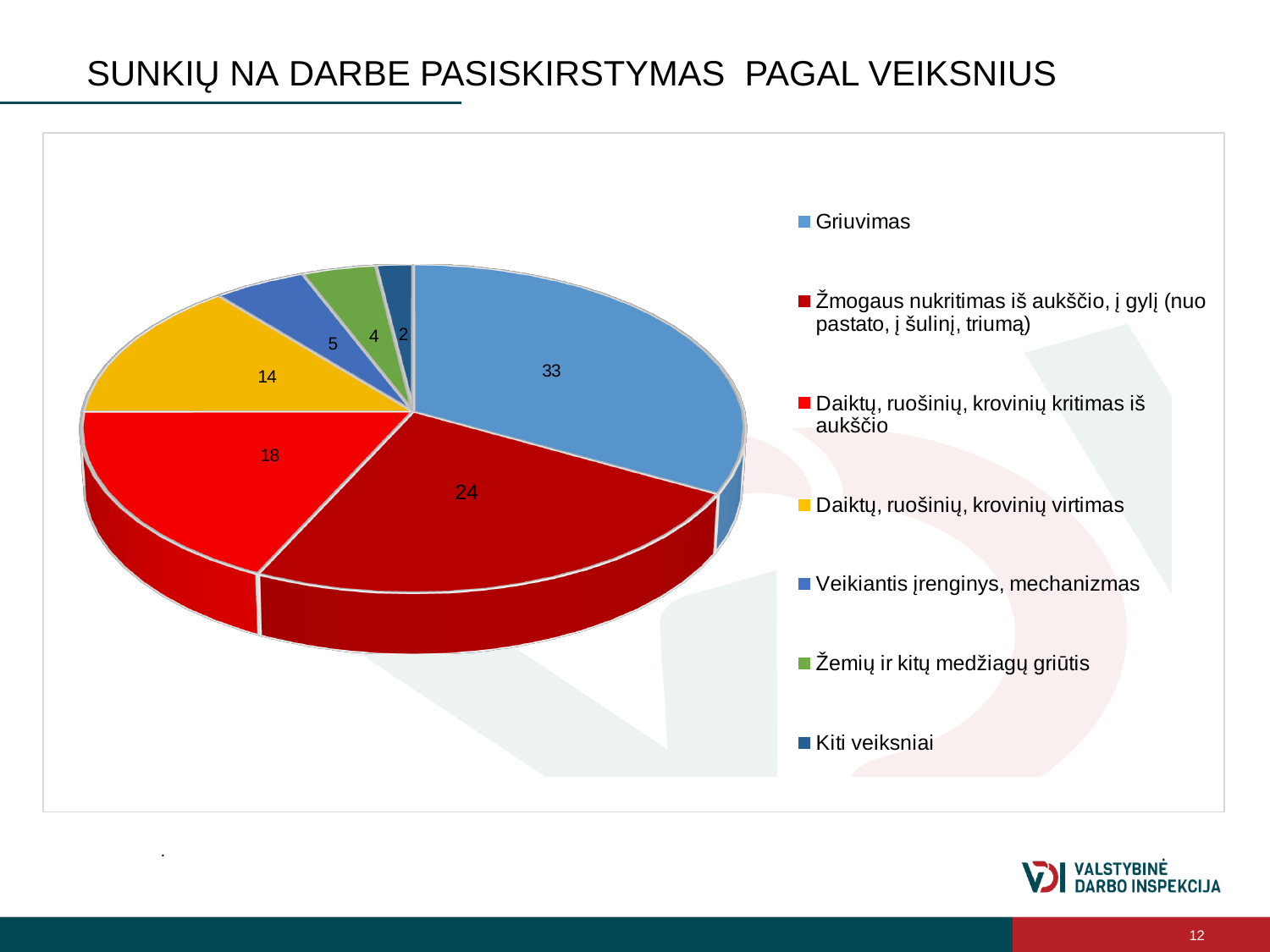
What share of the pie does Žmogaus nukritimas iš aukščio, į gylį represent? 24% Which is larger, the value for Daiktų, ruošinių, krovinių kritimas iš aukščio or the value for Daiktų, ruošinių, krovinių virtimas? Daiktų, ruošinių, krovinių kritimas iš aukščio What is the value for Kiti veiksniai? 2 Which category has the smallest slice of the pie? Kiti veiksniai What is the value for Daiktų, ruošinių, krovinių virtimas? 14 How many categories does the pie chart have? 7 What is the title of the slide? SUNKIŲ NA DARBE PASISKIRSTYMAS PAGAL VEIKSNIUS What is the difference between the values for Griuvimas and Žmogaus nukritimas iš aukščio, į gylį? 9 Which category has the largest slice of the pie? Griuvimas What kind of chart is shown on the slide? pie chart What is the value for Veikiantis įrenginys, mechanizmas? 5 What is the value for Griuvimas? 33